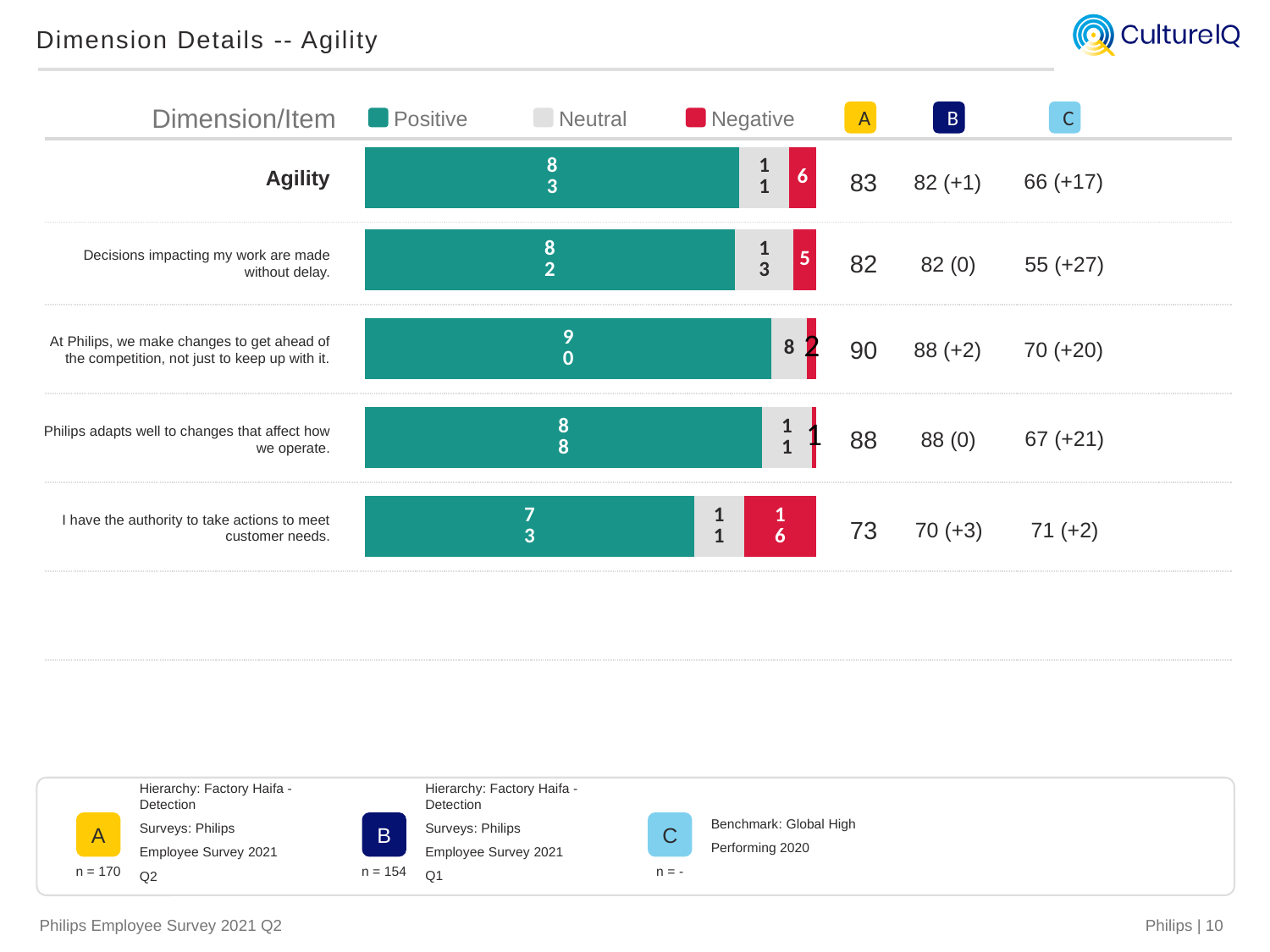
How many items (rows) are plotted in the chart? 5 What is the total of the Positive, Neutral and Negative segments for the Agility row? 100 What kind of chart is shown on the slide? Stacked bar chart What is the Negative value for 'I have the authority to take actions to meet customer needs.'? 16 What is the Neutral value for 'Decisions impacting my work are made without delay.'? 13 What is the difference between the Positive values for 'Philips adapts well to changes that affect how we operate.' and 'I have the authority to take actions to meet customer needs.'? 15 Which item has the lowest Positive value? I have the authority to take actions to meet customer needs. Which has a larger Negative value: 'Decisions impacting my work are made without delay.' or 'I have the authority to take actions to meet customer needs.'? I have the authority to take actions to meet customer needs. What is the Positive value for the Agility row? 83 How many series does the legend list? 3 What colour represents the Negative series in the legend? Red Which item has the highest Positive value? At Philips, we make changes to get ahead of the competition, not just to keep up with it.